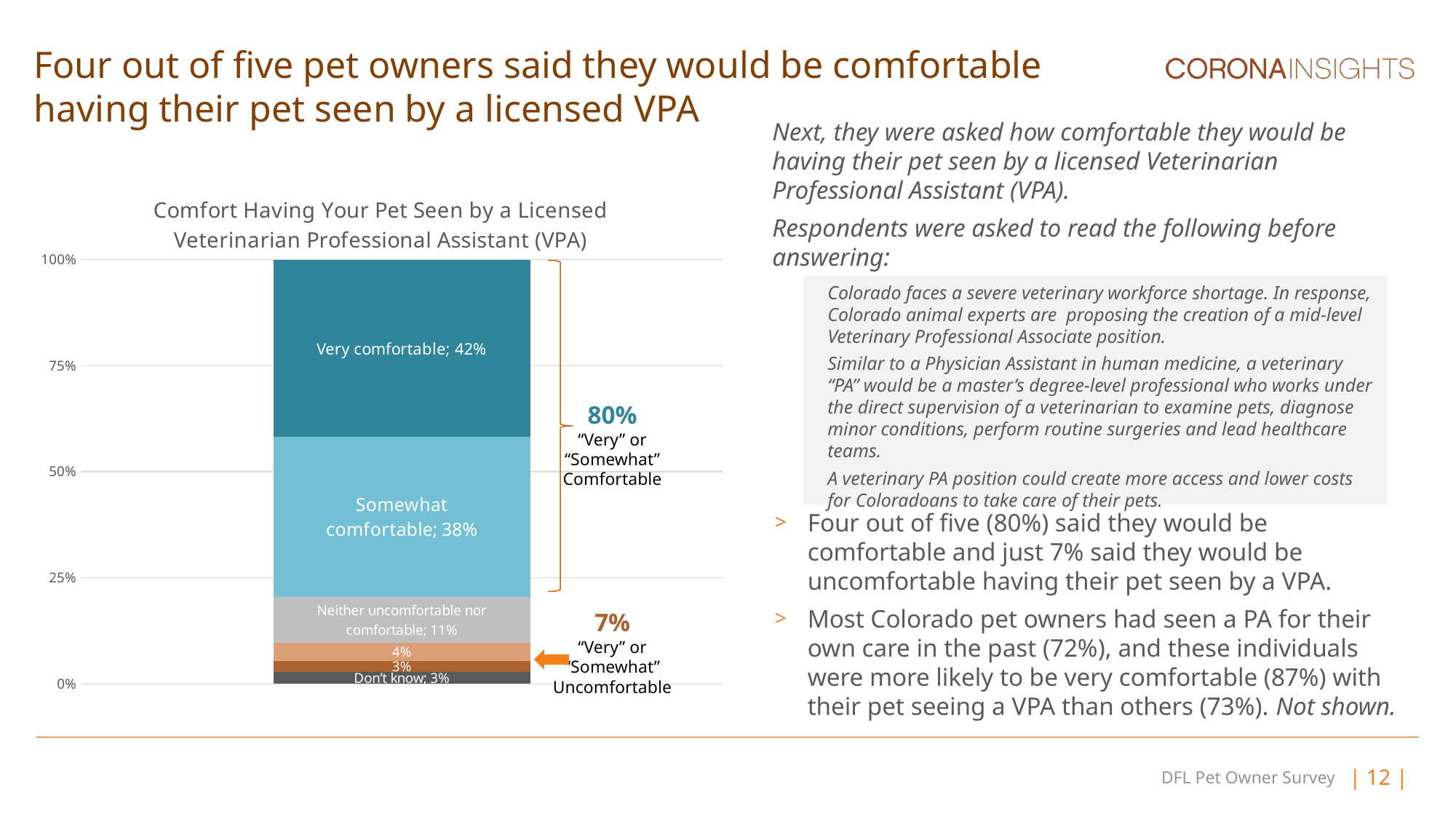
What combined percentage is shown for 'Very' or 'Somewhat' Comfortable? 80% What share of respondents were neither uncomfortable nor comfortable? 11% What percentage of pet owners said they were very comfortable having their pet seen by a licensed VPA? 42% Which is larger: the share for 'Somewhat comfortable' or the share for 'Neither uncomfortable nor comfortable'? Somewhat comfortable What type of chart is shown on the slide? Stacked bar chart What is the difference between the 'Very comfortable' and 'Somewhat comfortable' shares? 4 percentage points What combined percentage is shown for 'Very' or 'Somewhat' Uncomfortable? 7% How many segments make up the stacked bar? 6 What is the title of the chart? Comfort Having Your Pet Seen by a Licensed Veterinarian Professional Assistant (VPA) What percentage of respondents answered 'Don't know'? 3% Which response category has the largest share in the chart? Very comfortable What percentage of respondents said they were somewhat comfortable? 38%